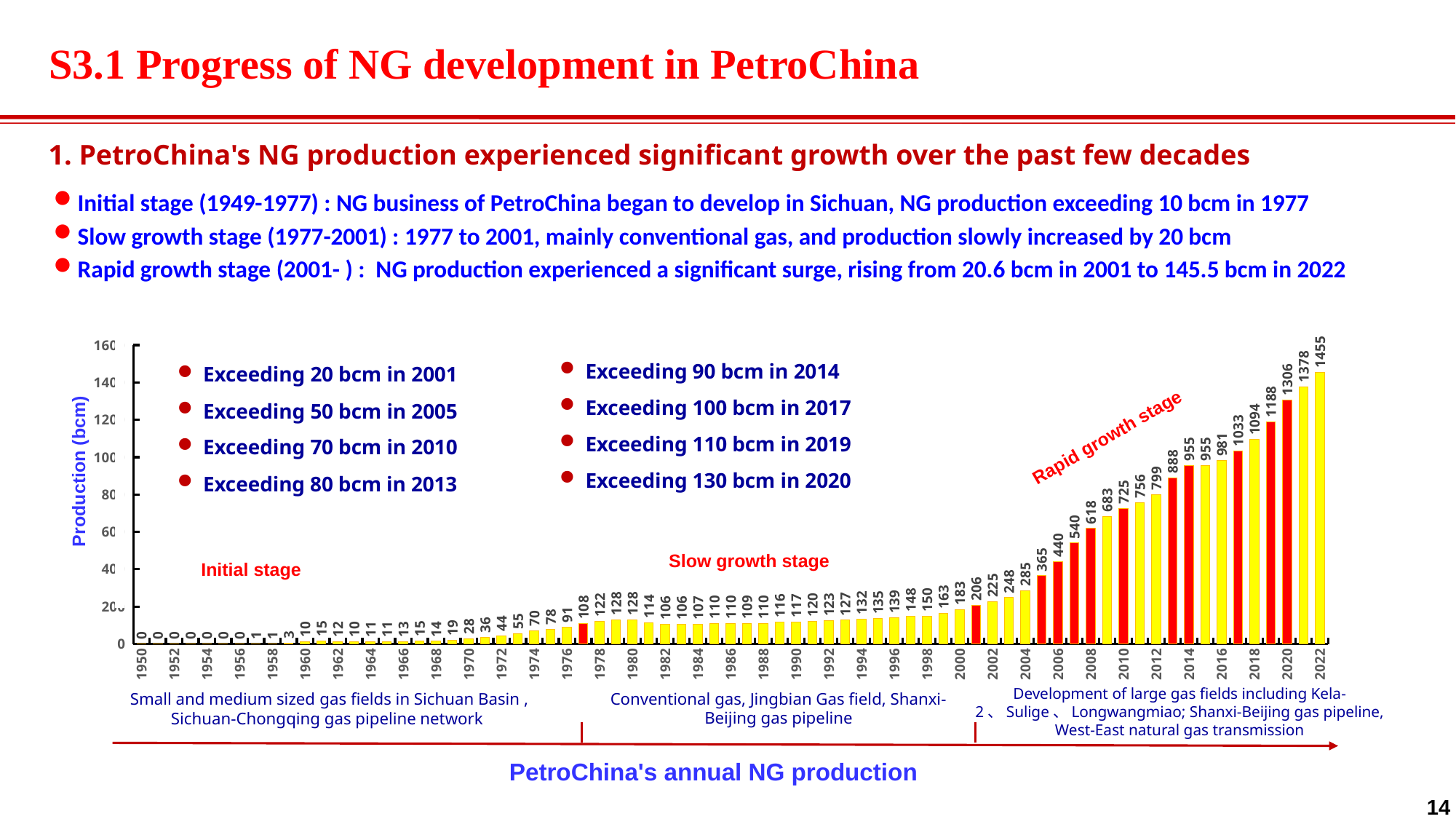
What is the data label on the bar for 2010? 725 What is the data label on the bar for 2022? 1455 Overall, do the production bars rise or fall from 1950 to 2022? rise What is the data label on the bar for 2020? 1306 Is the production value for 2022 greater or less than 140 bcm on the axis? greater What is the title of the chart's vertical axis? Production (bcm) Which year has the highest production bar? 2022 What is the data label on the bar for 2000? 183 What is the title of the chart? PetroChina's annual NG production What is the difference between the data labels for 2022 and 2021? 77 Which year has the larger bar, 2018 or 2010? 2018 What type of chart is shown on the slide? bar chart